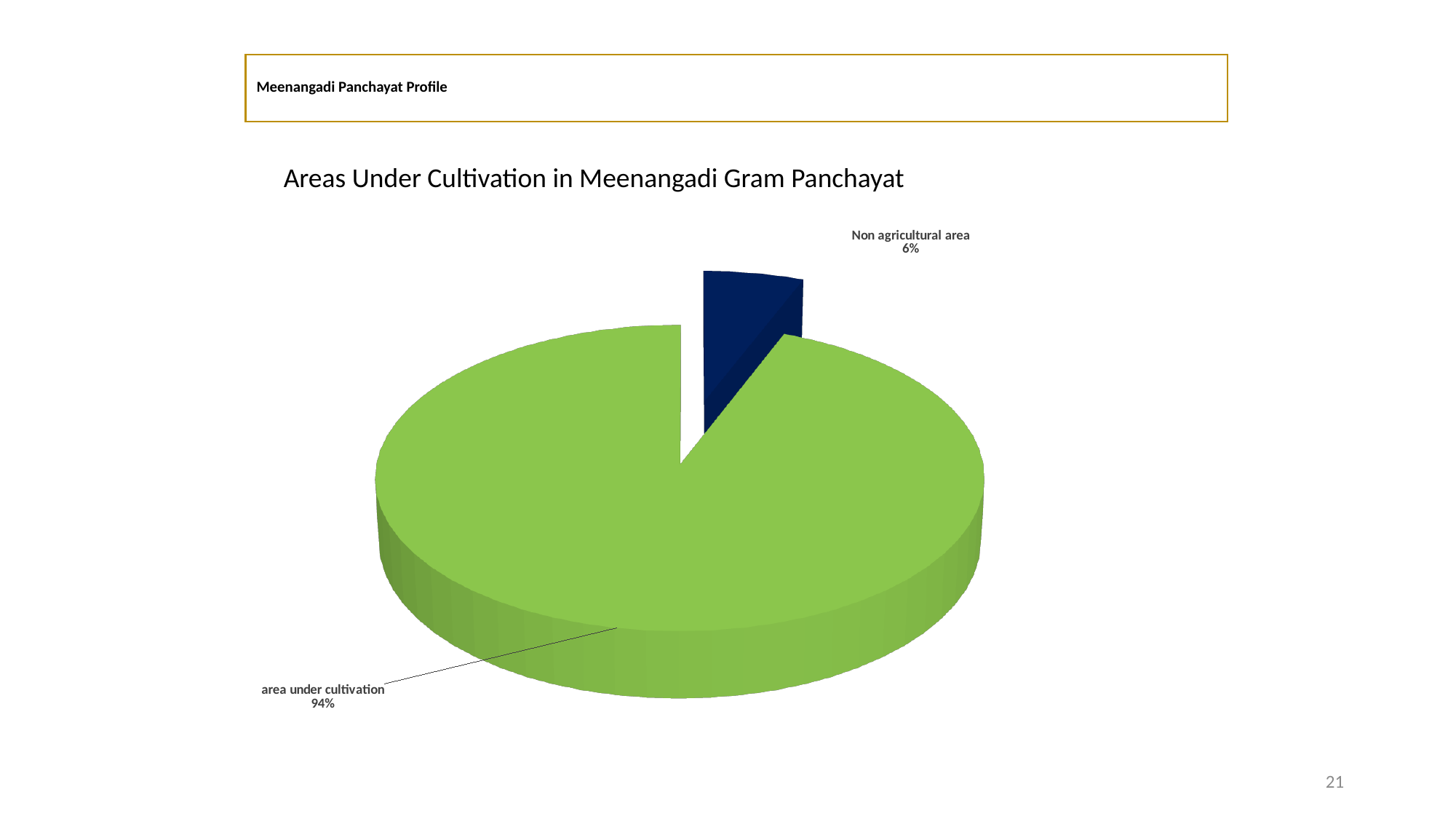
What is the difference in percentage points between 'area under cultivation' and 'Non agricultural area'? 88 What is the title of the chart? Areas Under Cultivation in Meenangadi Gram Panchayat What colour is the 'Non agricultural area' slice? dark blue Which slice of the pie is the smallest? Non agricultural area How many slices does the pie chart have? 2 What share of the pie is labelled 'Non agricultural area'? 6% Which slice of the pie is the largest? area under cultivation Which is larger, the share for 'area under cultivation' or the share for 'Non agricultural area'? area under cultivation What share of the pie is labelled 'area under cultivation'? 94% What kind of chart is shown on the slide? pie chart